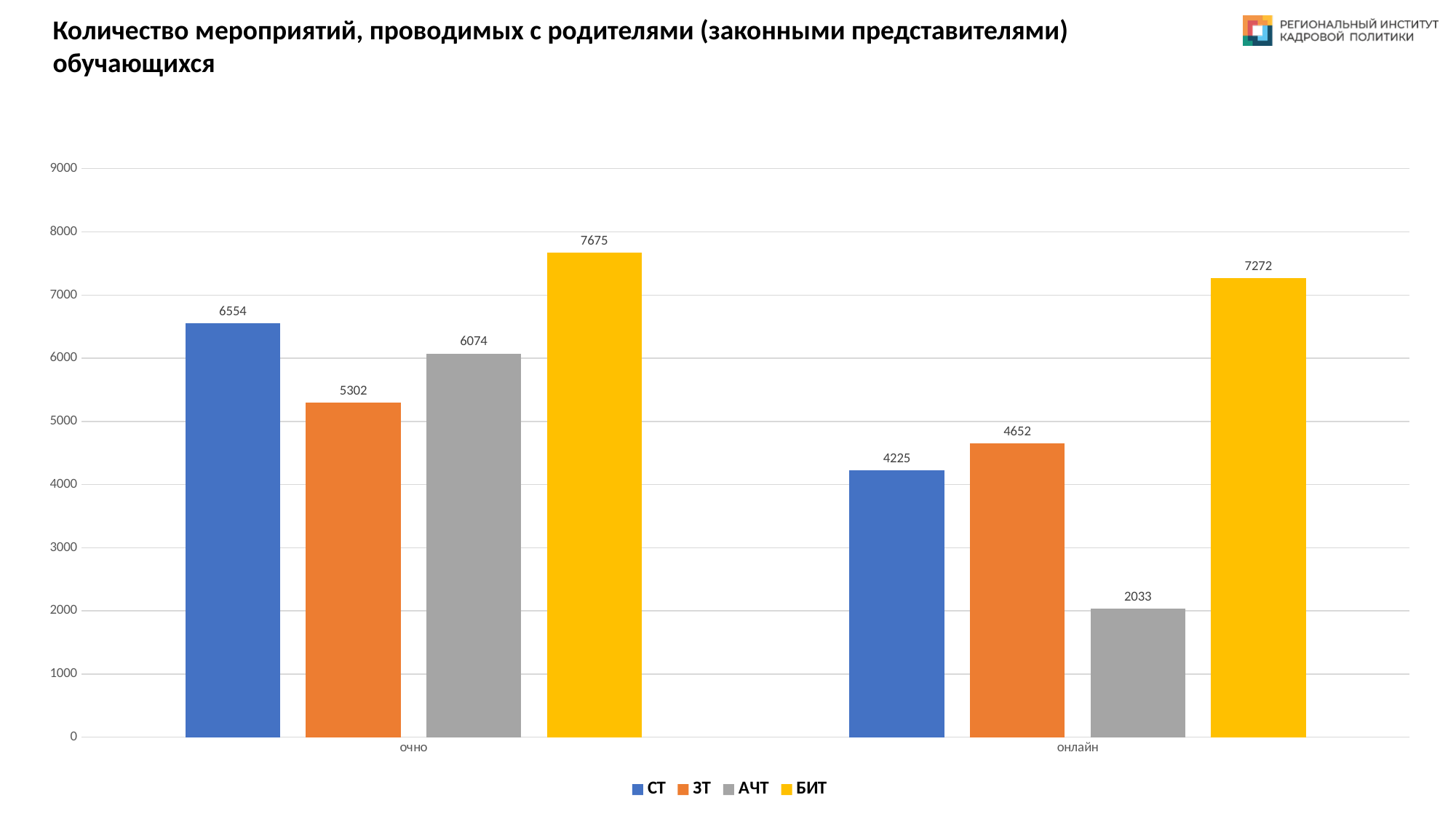
What kind of chart is shown on the slide? bar chart What is the value for АЧТ in the онлайн category? 2033 How many series does the legend list? 4 What is the difference between the БИТ values for очно and онлайн? 403 Which series has the lowest value in the очно category? ЗТ What is the value for БИТ in the очно category? 7675 Is the value for АЧТ in the онлайн category greater or less than 3000? less How many categories are shown on the x axis? 2 Which series has the highest value in the онлайн category? БИТ What is the difference between СТ and ЗТ in the онлайн category? 427 Which is larger: СТ in очно or АЧТ in очно? СТ in очно What is the value for ЗТ in the очно category? 5302